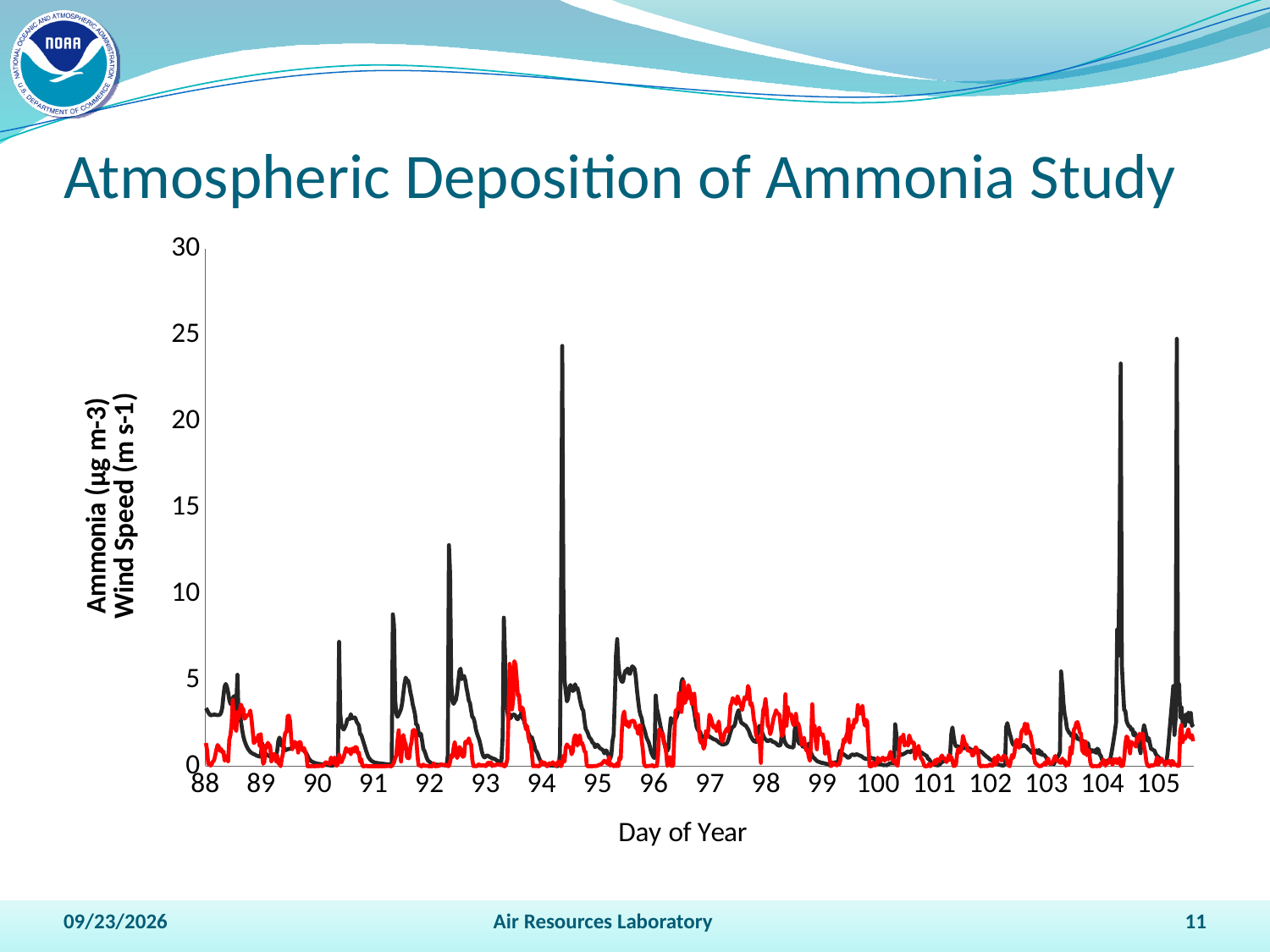
Is the peak of the black line near day 92 greater or less than 10? greater What kind of chart is shown on the slide? line chart Is the highest value reached by the red line greater or less than 10? less How many lines (series) are plotted on the chart? 2 Between day 99 and day 105, does the red line stay below 5 or rise above 5? below 5 What is the label of the x axis of the chart? Day of Year How many day-of-year tick labels are shown on the x axis? 18 Which line reaches the highest value on the chart, the black line or the red line? black line What is the title of the slide containing the chart? Atmospheric Deposition of Ammonia Study